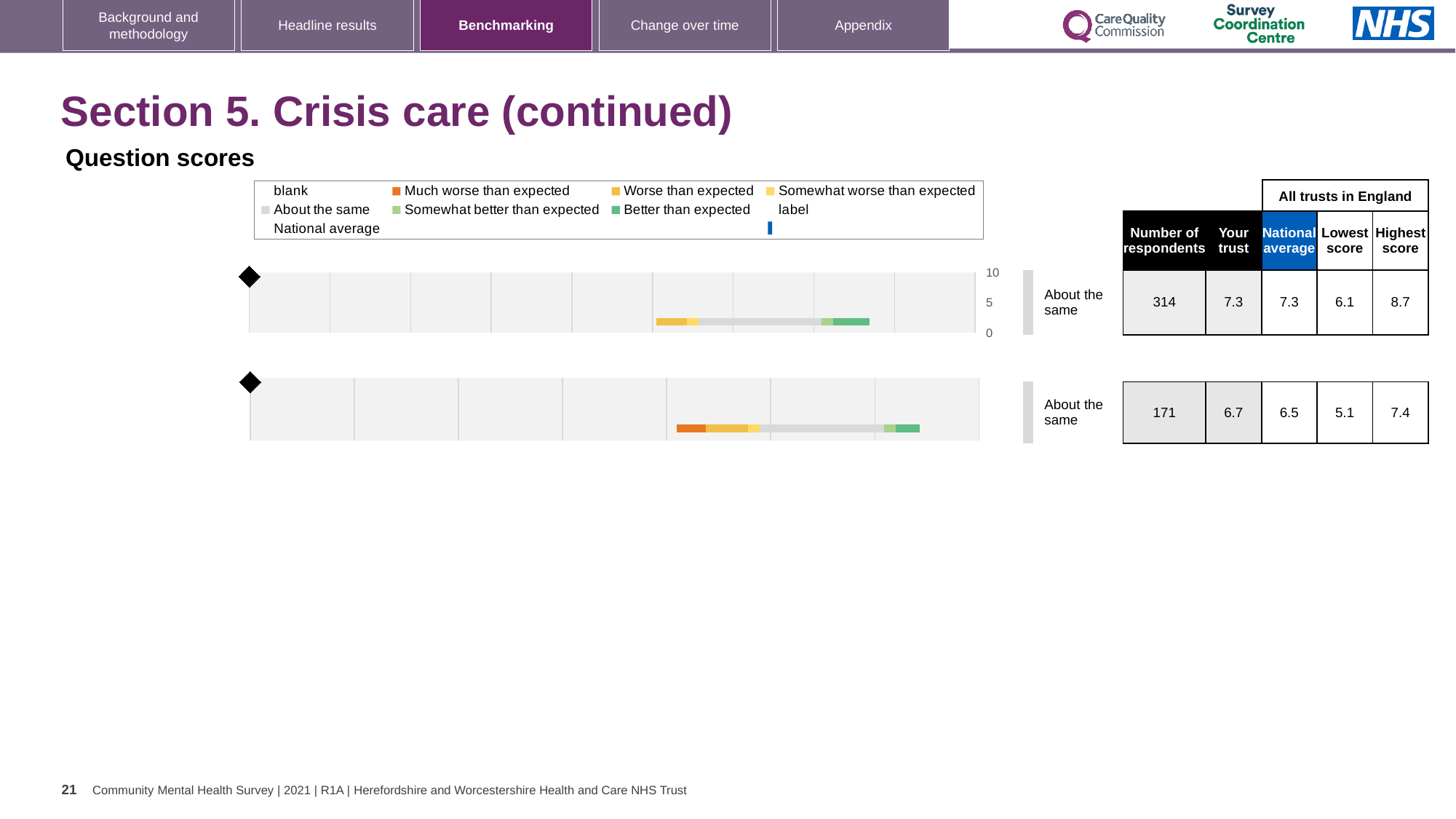
For the bottom chart, what is the difference between the highest score and the lowest score? 2.3 How many charts are shown on the slide? 2 What kind of chart is used on this slide to show the question scores? bar chart For the top chart, what is the highest score among all trusts in England? 8.7 For the bottom chart, what is the national average score? 6.5 What benchmark category is shown next to both charts? About the same For the bottom chart, what is the 'Your trust' score? 6.7 For the bottom chart, is the 'Your trust' score larger or smaller than the national average? larger For the top chart, what is the 'Your trust' score? 7.3 For the top chart, what is the number of respondents shown in the table? 314 For the bottom chart, what is the lowest score among all trusts in England? 5.1 In the legend, which colour represents 'Much worse than expected'? orange